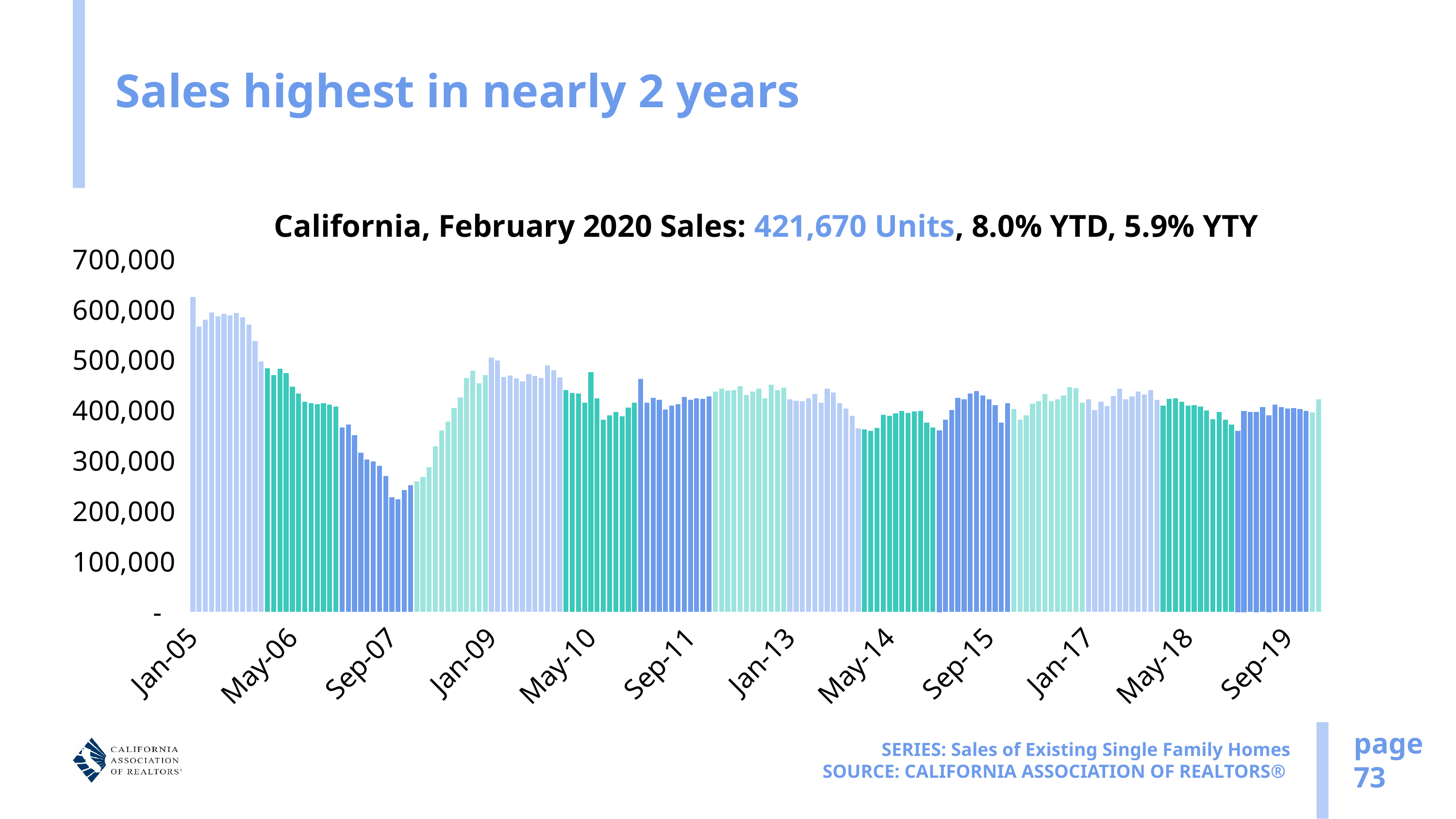
What kind of chart is shown on the slide? bar chart Is the value for Jan-05 greater or less than 600,000? greater What is the year-to-date (YTD) percentage change stated in the chart title? 8.0% According to the chart title, how many units were sold in California in February 2020? 421,670 Units How many period labels are shown on the x axis? 12 Do sales rise or fall between Jan-05 and Sep-07? fall What is the year-to-year (YTY) percentage change stated in the chart title? 5.9% Which is larger, the value for Jan-05 or the value for Sep-19? Jan-05 Is the lowest bar on the chart greater or less than 300,000? less Is the value for Jan-09 greater or less than 400,000? greater Which labelled x-axis period has the highest sales on the chart? Jan-05